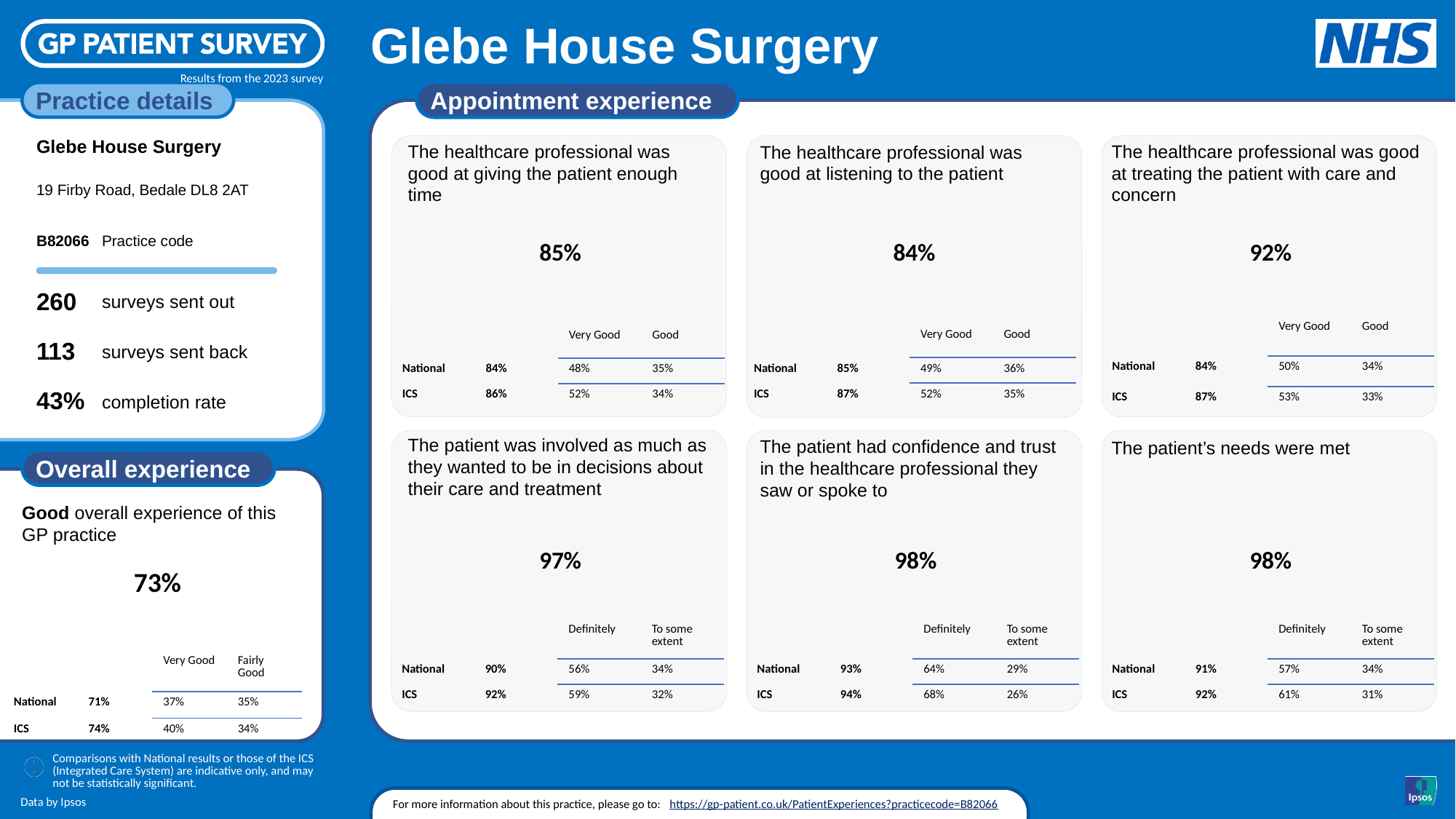
On the panel 'The healthcare professional was good at treating the patient with care and concern', what is the National 'Very Good' percentage? 50% On the 'Overall experience' panel, what percentage of patients reported a good overall experience of this GP practice? 73% On the 'Overall experience' panel, what are the two response categories listed in the comparison table? Very Good and Fairly Good On the 'Overall experience' panel, what is the ICS 'Very Good' percentage? 40% On the panel 'The patient was involved as much as they wanted to be in decisions about their care and treatment', what is the difference between the practice's headline percentage and the National figure? 7% Across the six 'Appointment experience' panels, which question has the lowest practice headline percentage? The healthcare professional was good at listening to the patient On the panel 'The healthcare professional was good at giving the patient enough time', what is the practice's headline percentage? 85% On the 'Overall experience' panel, what is the National figure for good overall experience? 71% On the panel 'The healthcare professional was good at listening to the patient', what is the ICS figure? 87% How many question panels are shown under the 'Appointment experience' heading? 6 On the panel 'The patient had confidence and trust in the healthcare professional they saw or spoke to', which is larger: the National 'Definitely' percentage or the ICS 'Definitely' percentage? ICS On the panel 'The patient's needs were met', what is the sum of the ICS 'Definitely' and 'To some extent' percentages? 92%